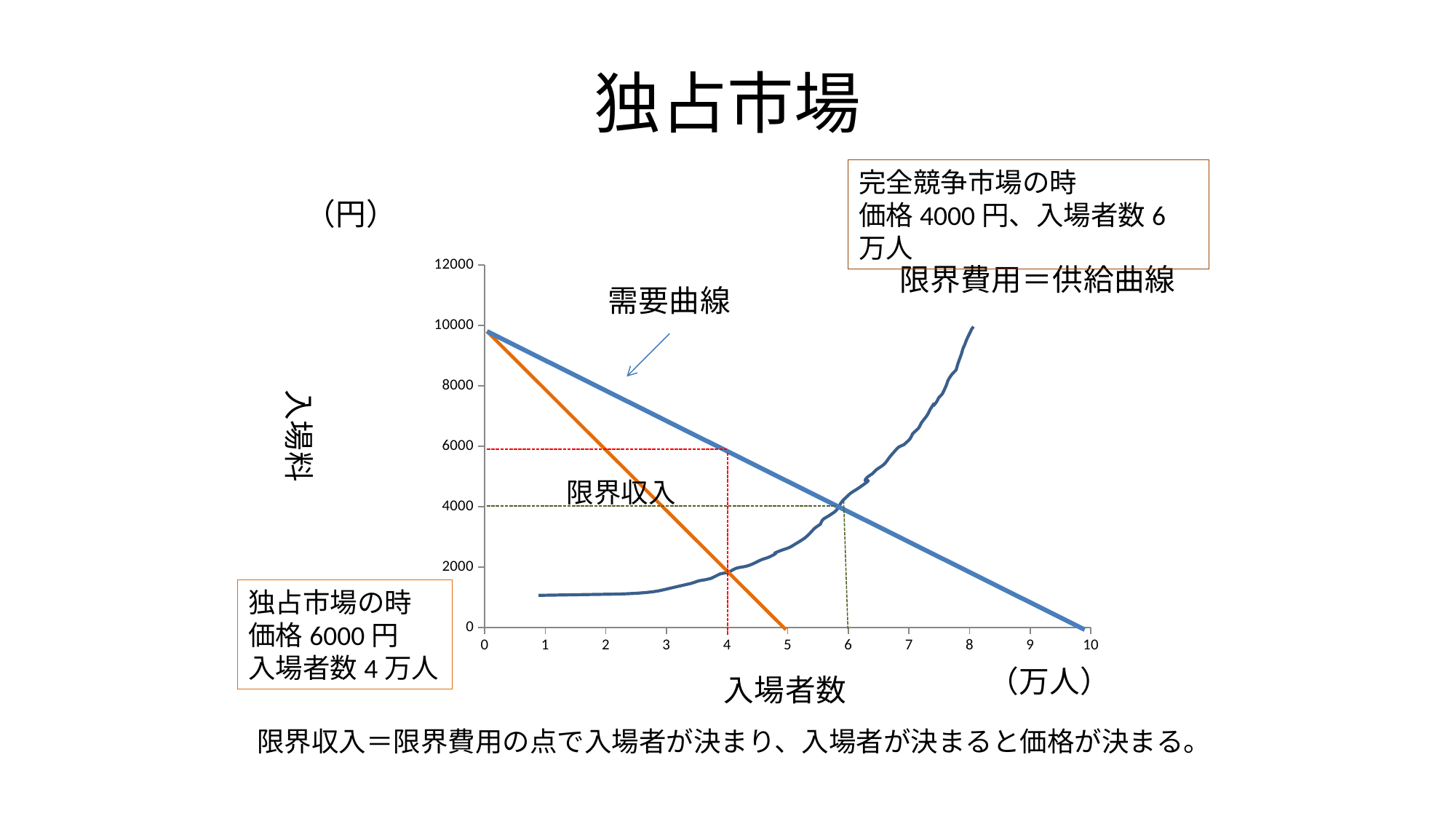
What kind of chart is shown on the slide? line chart Is the value of the supply curve (限界費用＝供給曲線) at 1万人 greater or less than 2000? less Is the value of the demand curve (需要曲線) at 0 attendees greater or less than 8000? greater Does the demand curve (需要曲線) rise or fall as the number of attendees increases? fall According to the slide, what is the number of attendees (入場者数) in the perfectly competitive market (完全競争市場の時)? 6万人 How much higher is the monopoly price than the perfectly competitive price? 2000円 According to the slide, what is the number of attendees (入場者数) in the monopoly market (独占市場の時)? 4万人 How many curves are plotted on the chart? 3 According to the slide, what is the price (価格) in the monopoly market (独占市場の時)? 6000円 According to the slide, what is the price (価格) in the perfectly competitive market (完全競争市場の時)? 4000円 Does the marginal cost / supply curve (限界費用＝供給曲線) rise or fall as the number of attendees increases? rise At 4万人 attendees, which is higher: the demand curve (需要曲線) or the supply curve (限界費用＝供給曲線)? 需要曲線